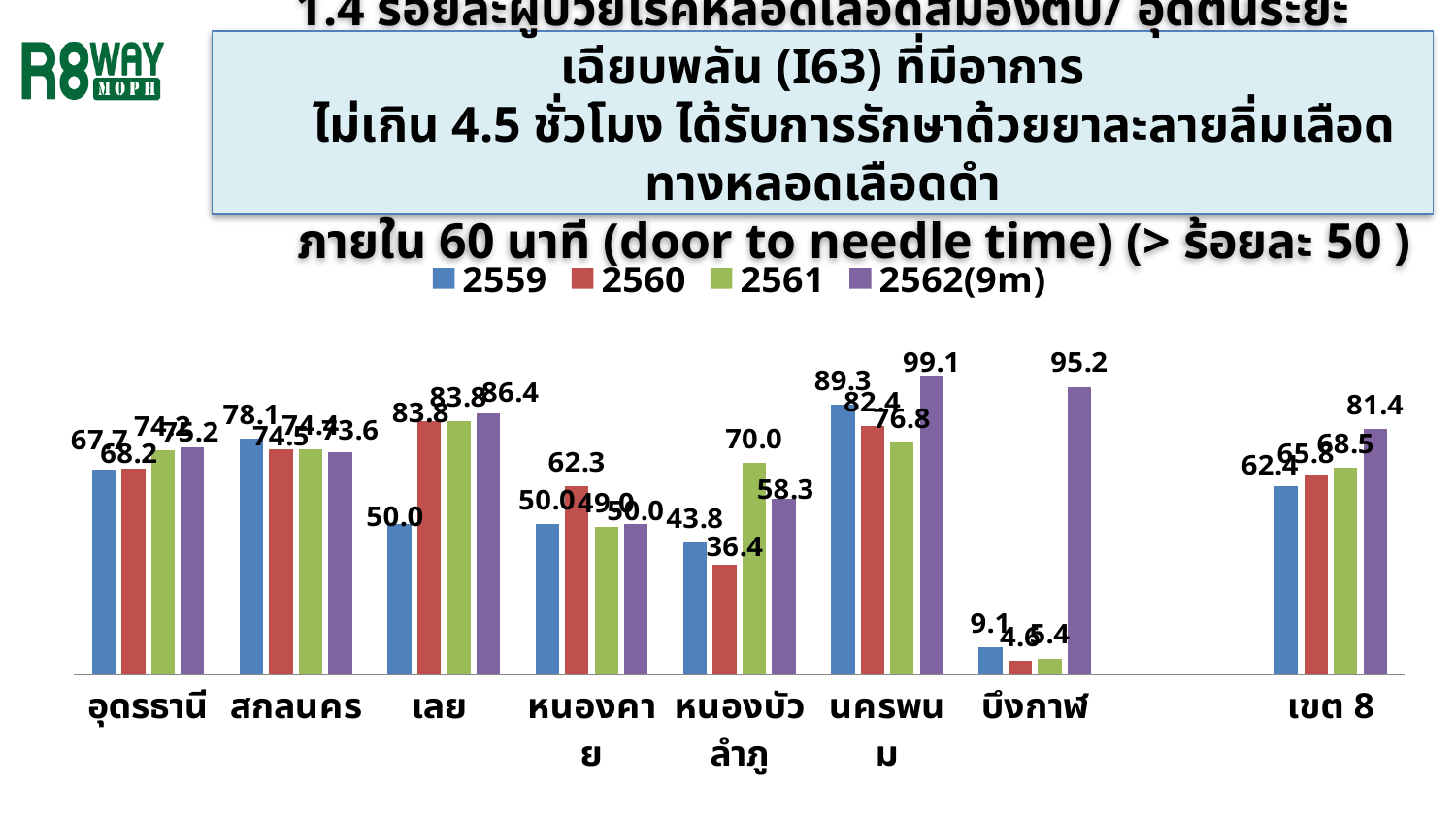
What is the value for เลย in the 2559 series? 50.0 What is the value for นครพนม in the 2562(9m) series? 99.1 What is the value for บึงกาฬ in the 2562(9m) series? 95.2 What is the value for หนองบัวลำภู in the 2561 series? 70.0 How many series does the legend list? 4 How many categories are shown along the x axis? 8 For หนองบัวลำภู, which is larger: the 2560 value or the 2561 value? 2561 What kind of chart is shown on the slide? bar chart Do the values for เขต 8 rise or fall from 2559 to 2562(9m)? rise Which category has the lowest value in the 2559 series? บึงกาฬ What is the difference between the 2562(9m) and 2559 values for เขต 8? 19.0 Which category has the highest value in the 2562(9m) series? นครพนม